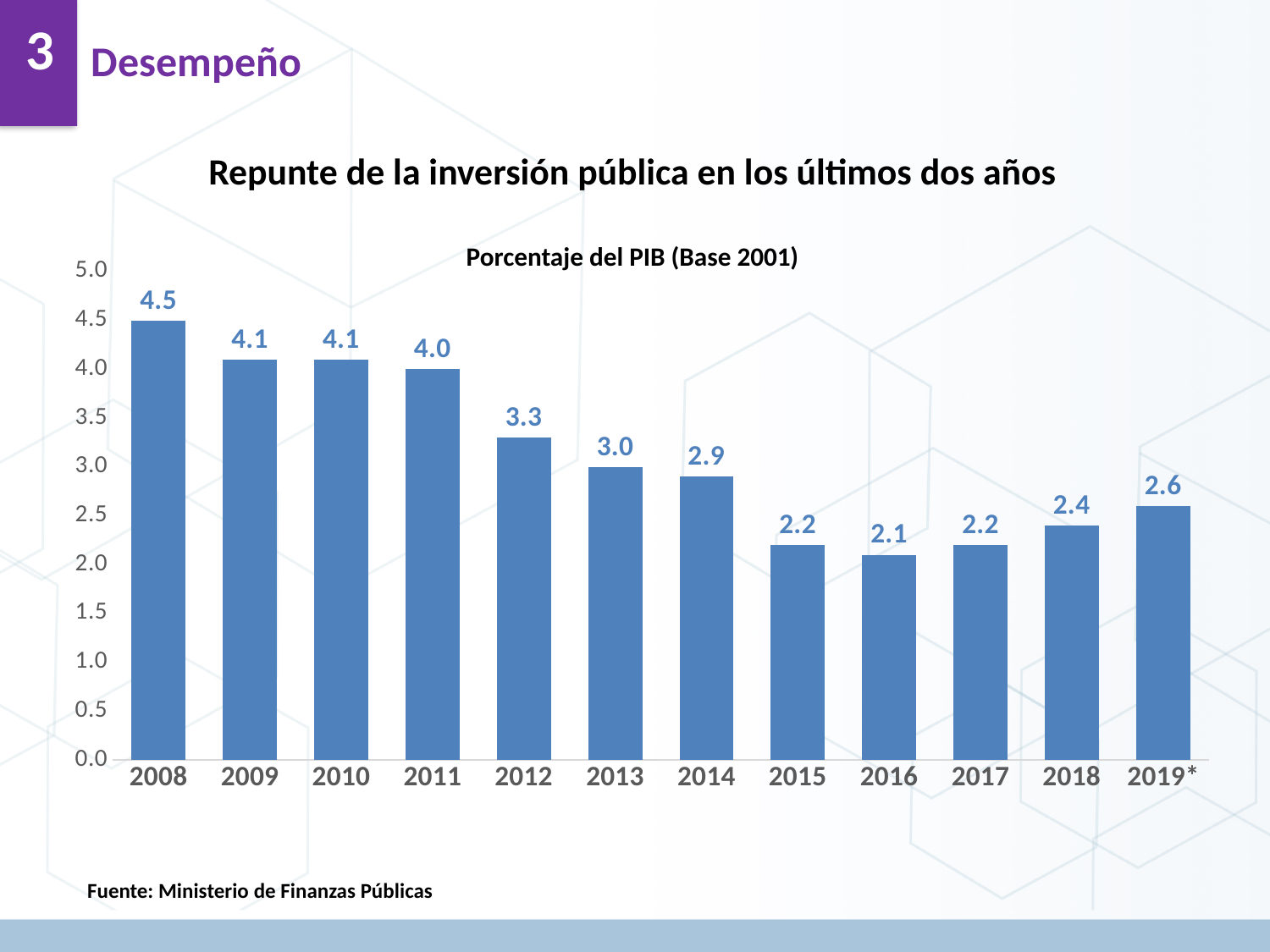
How many years are shown on the x axis? 12 Do the values generally rise or fall from 2008 to 2016? fall What is the difference between the values for 2008 and 2019*? 1.9 What is the value for 2008? 4.5 What is the difference between the values for 2012 and 2013? 0.3 What is the chart's subtitle above the plot area? Porcentaje del PIB (Base 2001) What is the value for 2019*? 2.6 Which year has the lowest value? 2016 What kind of chart is this? bar chart Which is larger, the value for 2014 or the value for 2018? 2014 What is the value for 2016? 2.1 Which year has the highest value? 2008